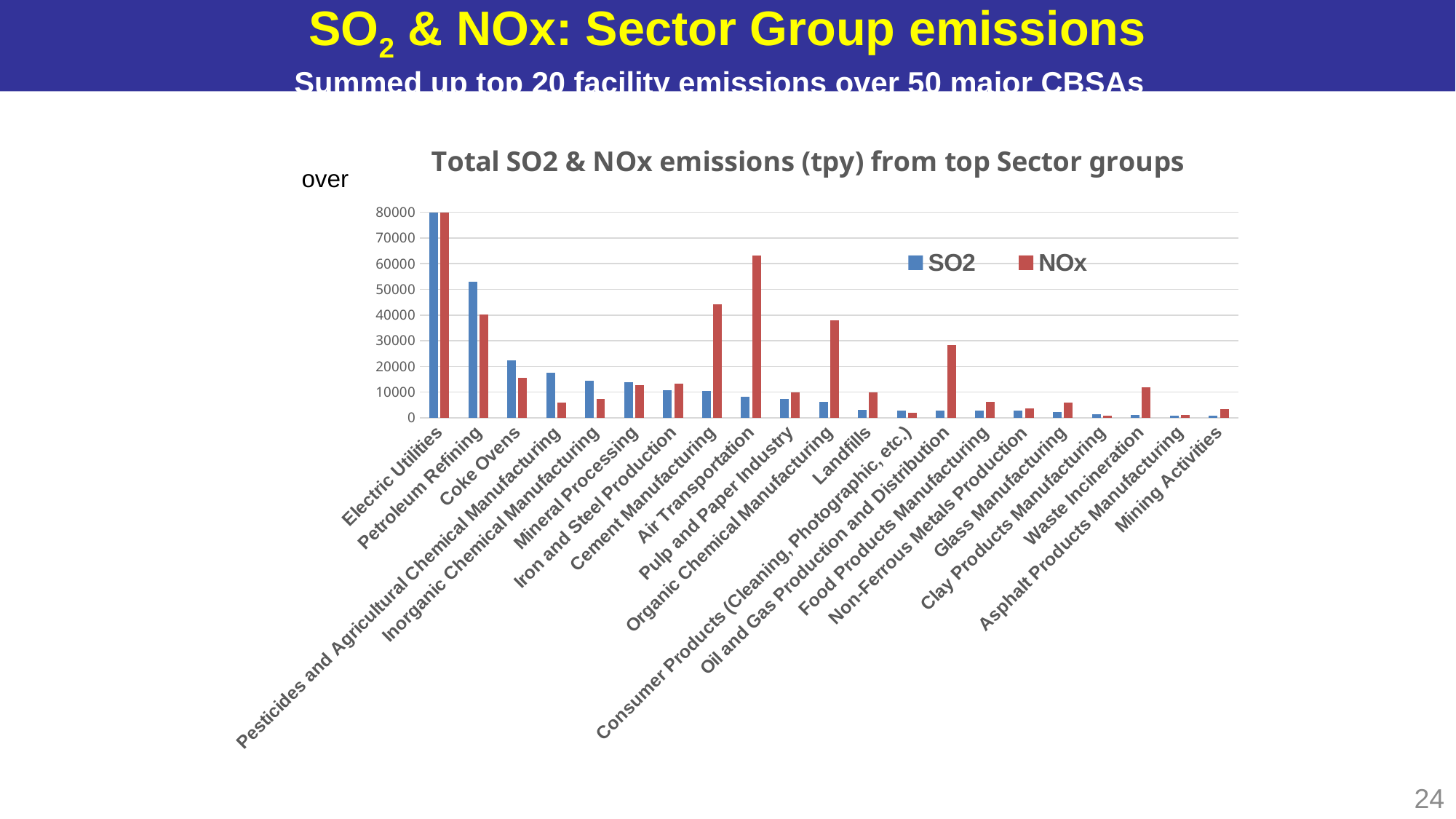
For Air Transportation, which is larger, SO2 or NOx emissions? NOx What kind of chart is shown on the slide? bar chart Is the SO2 value for Petroleum Refining greater or less than 40000? greater How many series does the legend list? 2 Is the SO2 value for Coke Ovens greater or less than 30000? less Do the SO2 values generally rise or fall moving from left to right along the x axis? fall Which sector group has the highest NOx emissions? Electric Utilities Is the NOx value for Organic Chemical Manufacturing greater or less than 30000? greater For Coke Ovens, which is larger, SO2 or NOx emissions? SO2 How many sector groups are plotted along the x axis? 21 Which sector group has the highest SO2 emissions? Electric Utilities